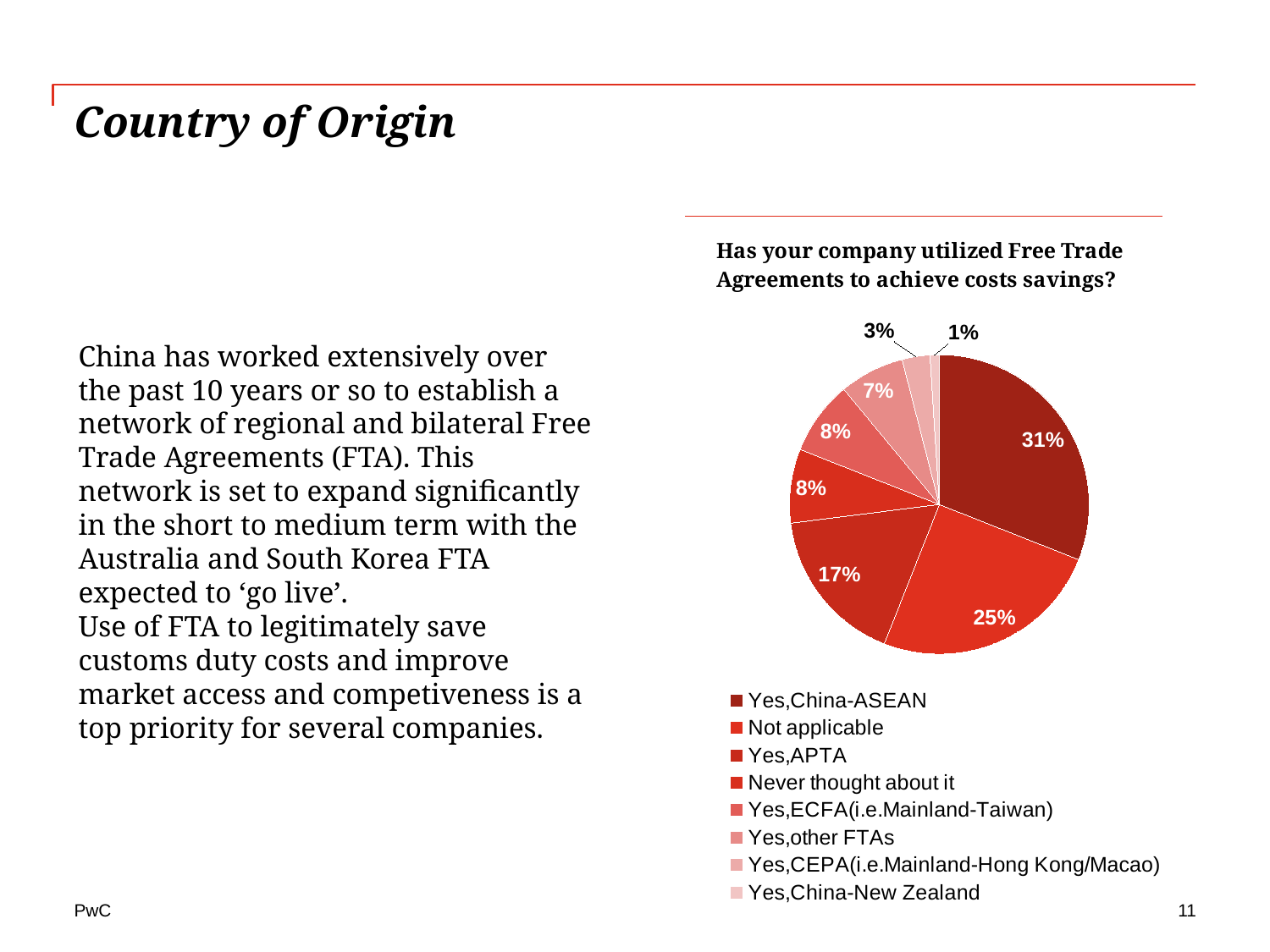
Which is larger, the share for 'Yes,APTA' or the share for 'Yes,other FTAs'? Yes,APTA What kind of chart is shown on the slide? pie chart What is the title of the chart? Has your company utilized Free Trade Agreements to achieve costs savings? What share of the pie is 'Yes,CEPA(i.e.Mainland-Hong Kong/Macao)'? 3% What share of the pie is 'Yes,China-New Zealand'? 1% Which category has the smallest slice of the pie? Yes,China-New Zealand What is the difference in percentage points between 'Yes,China-ASEAN' and 'Not applicable'? 6 How many categories does the legend of the pie chart list? 8 What share of the pie is 'Not applicable'? 25% Which category has the largest slice of the pie? Yes,China-ASEAN